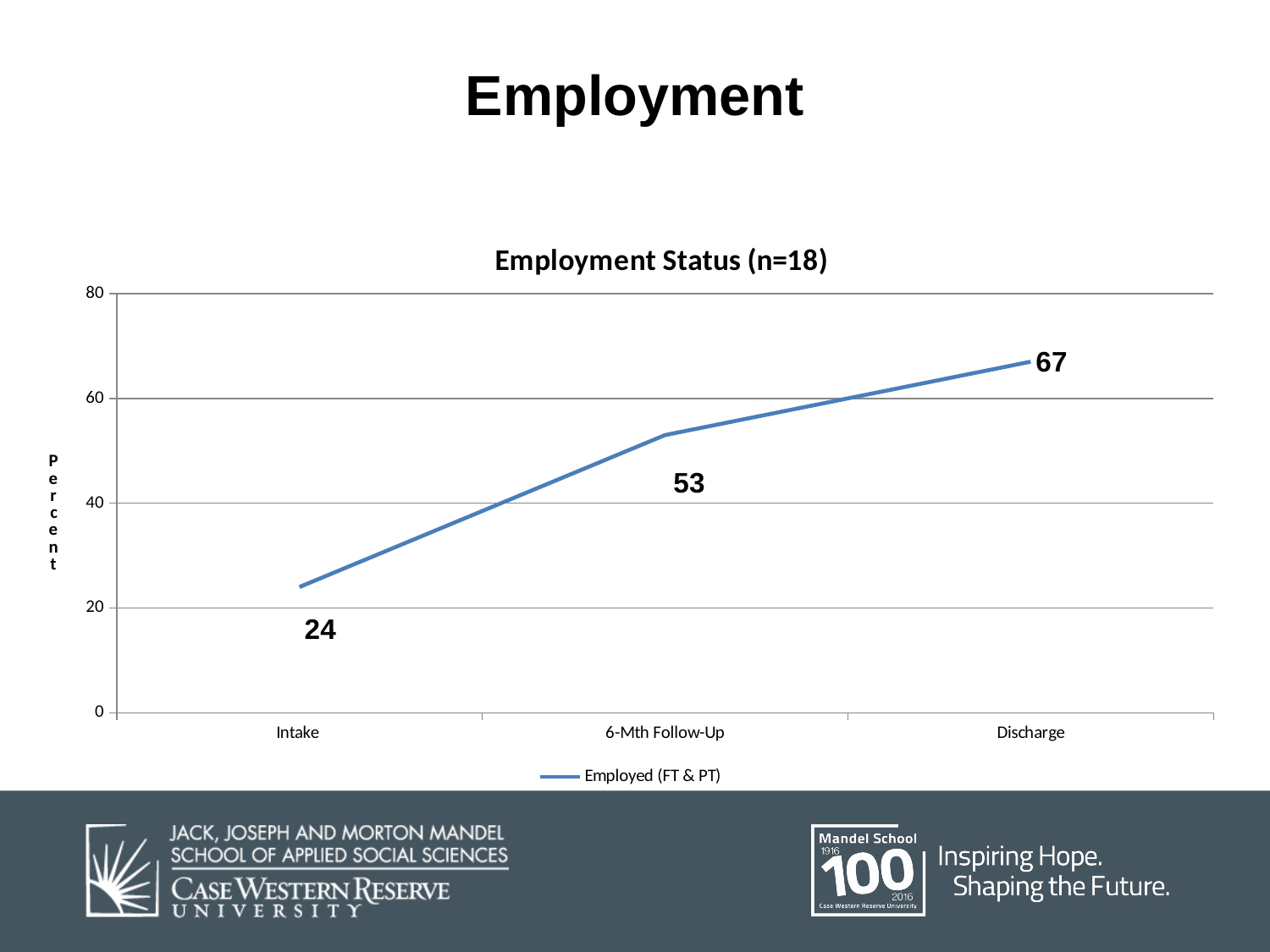
Do the values rise or fall from Intake to Discharge? rise Which is larger, the value at 6-Mth Follow-Up or at Discharge? Discharge How many time points are plotted on the chart? 3 Is the value for 6-Mth Follow-Up greater or less than 60? less Which time point has the lowest employment percentage? Intake What is the value for Discharge in the Employment Status chart? 67 What is the difference between the 6-Mth Follow-Up and Intake values? 29 What is the value for 6-Mth Follow-Up in the Employment Status chart? 53 What is the value for Intake in the Employment Status chart? 24 What kind of chart is shown on the slide? line chart Which time point has the highest employment percentage? Discharge What is the difference between the Discharge and Intake values? 43